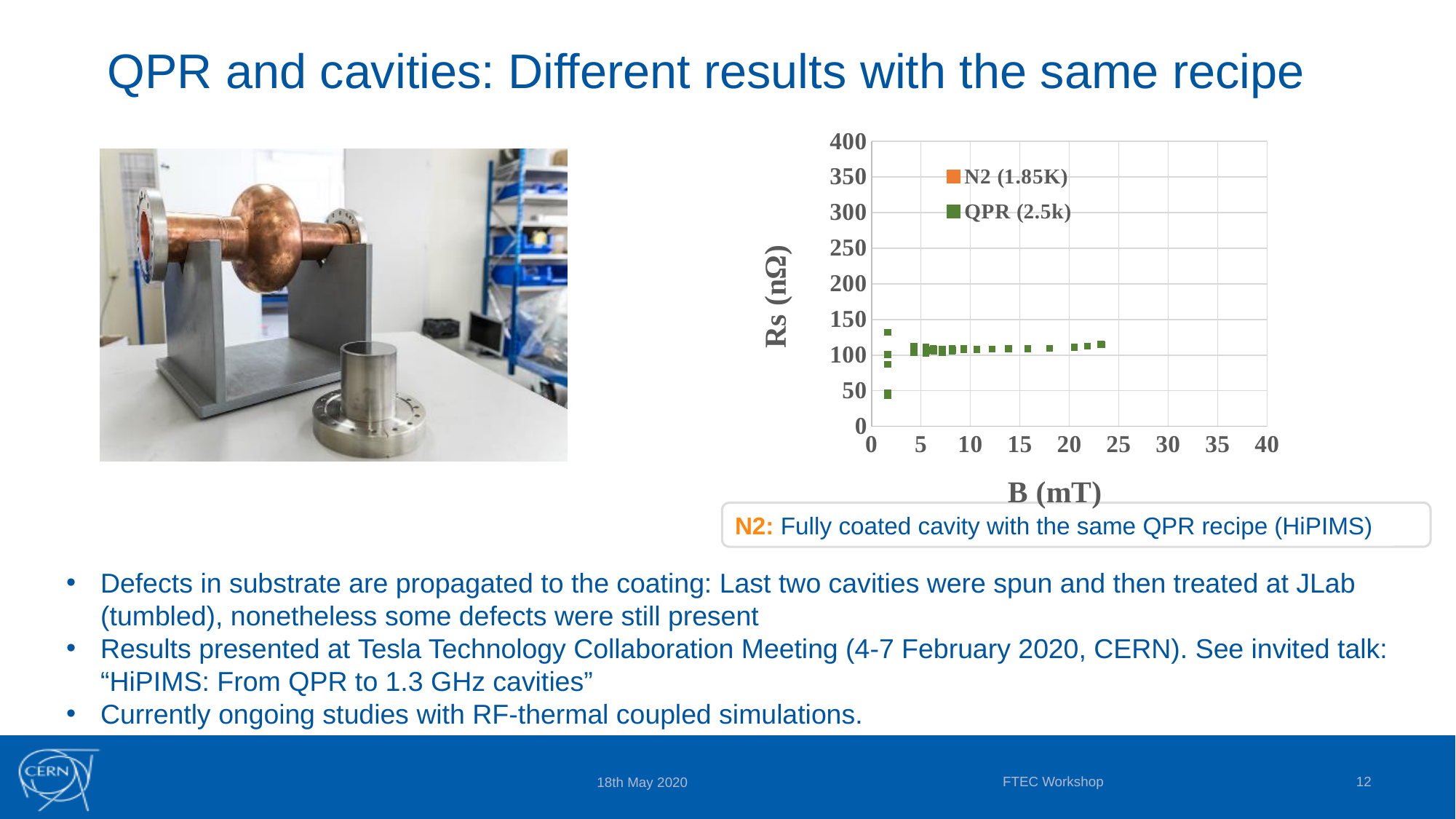
What kind of chart is shown on the slide? scatter chart Are the QPR (2.5k) values at B = 20 mT greater or less than 150 nΩ? less What is the maximum value shown on the x axis of the chart? 40 What is the label of the x axis of the chart? B (mT) Are the QPR (2.5k) values at B = 15 mT greater or less than 200 nΩ? less How many series does the chart legend list? 2 What is the label of the y axis of the chart? Rs (nΩ)